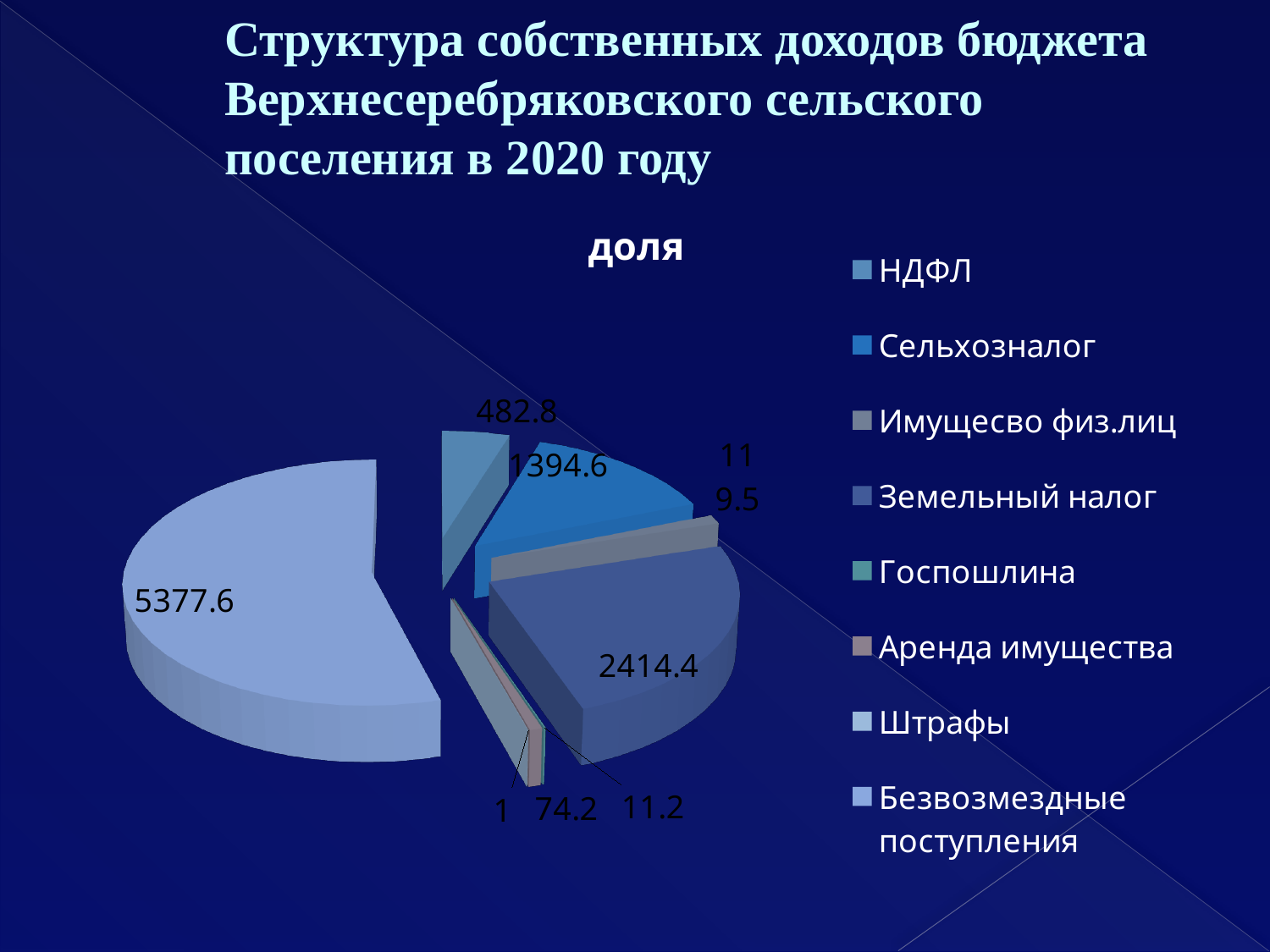
What is the value shown for Сельхозналог? 1394.6 What is the difference between the values for Безвозмездные поступления and Земельный налог? 2963.2 What kind of chart is shown on the slide? pie chart What is the value shown for Земельный налог? 2414.4 Which is larger, the value for Сельхозналог or the value for Земельный налог? Земельный налог How many entries does the legend of the pie chart list? 8 Which category has the largest slice in the pie chart? Безвозмездные поступления What is the difference between the values for Земельный налог and Сельхозналог? 1019.8 What is the title of the pie chart? доля What is the value shown for НДФЛ? 482.8 What is the value shown for Безвозмездные поступления? 5377.6 What is the smallest value printed as a data label on the pie chart? 1